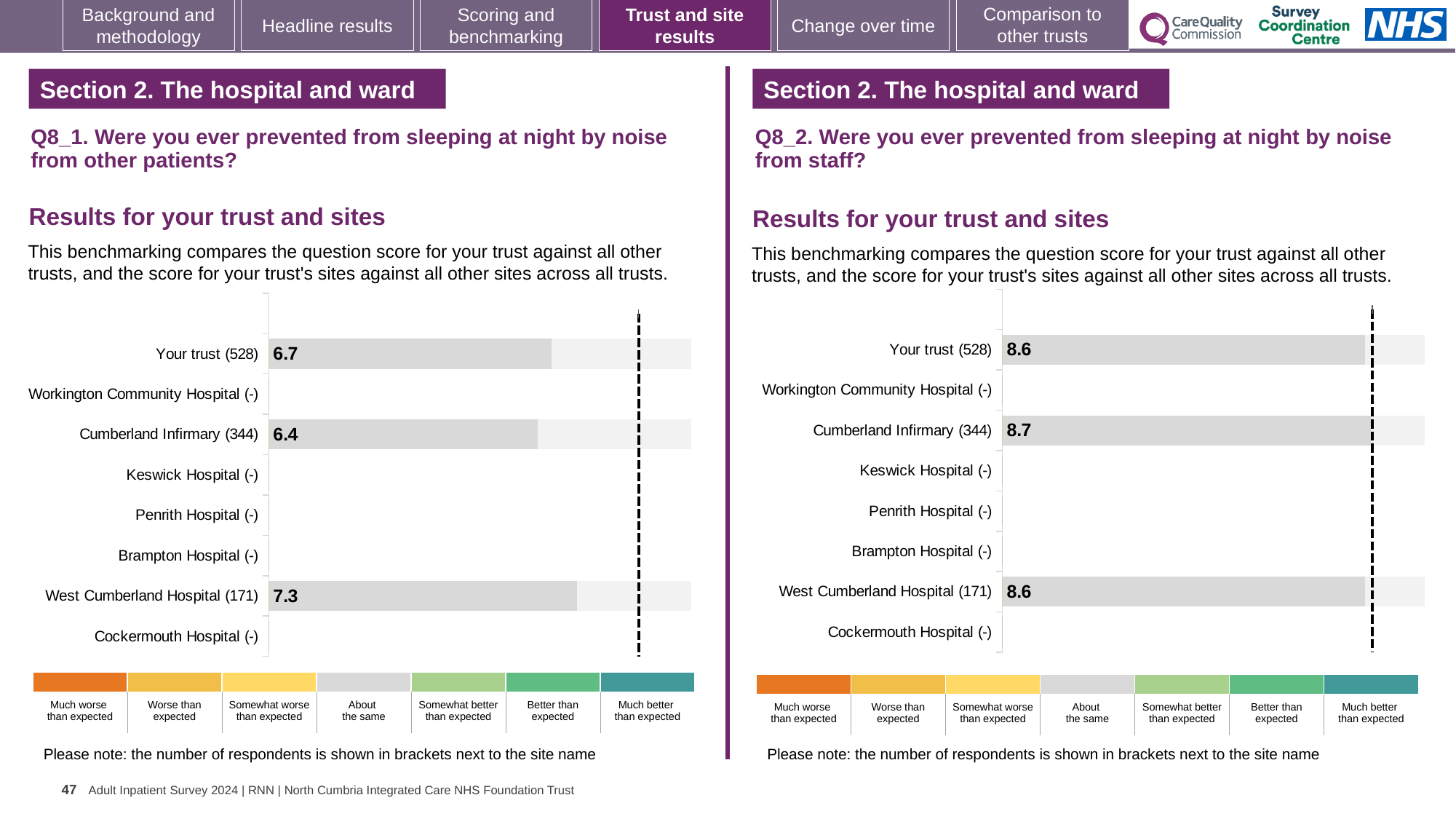
On the Q8_1 chart (left), what is the difference between the scores for West Cumberland Hospital (171) and Cumberland Infirmary (344)? 0.9 On the Q8_1 chart (left), which is larger: the score for Your trust (528) or for West Cumberland Hospital (171)? West Cumberland Hospital (171) On the Q8_1 chart (left), what is the score for West Cumberland Hospital (171)? 7.3 How many site rows (categories) are listed on the Q8_2 chart (right)? 8 What kind of chart is used on the Q8_1 chart (left)? Bar chart On the Q8_2 chart (right), what is the score for Cumberland Infirmary (344)? 8.7 On the Q8_2 chart (right), what is the score for Your trust (528)? 8.6 On the Q8_2 chart (right), what is the difference between the scores for Cumberland Infirmary (344) and Your trust (528)? 0.1 On the Q8_1 chart (left), what is the score for Your trust (528)? 6.7 On the Q8_1 chart (left), what is the score for Cumberland Infirmary (344)? 6.4 On the Q8_1 chart (left), which site has the lowest score among those with a bar? Cumberland Infirmary (344) On the Q8_1 chart (left), which site has the highest score? West Cumberland Hospital (171)